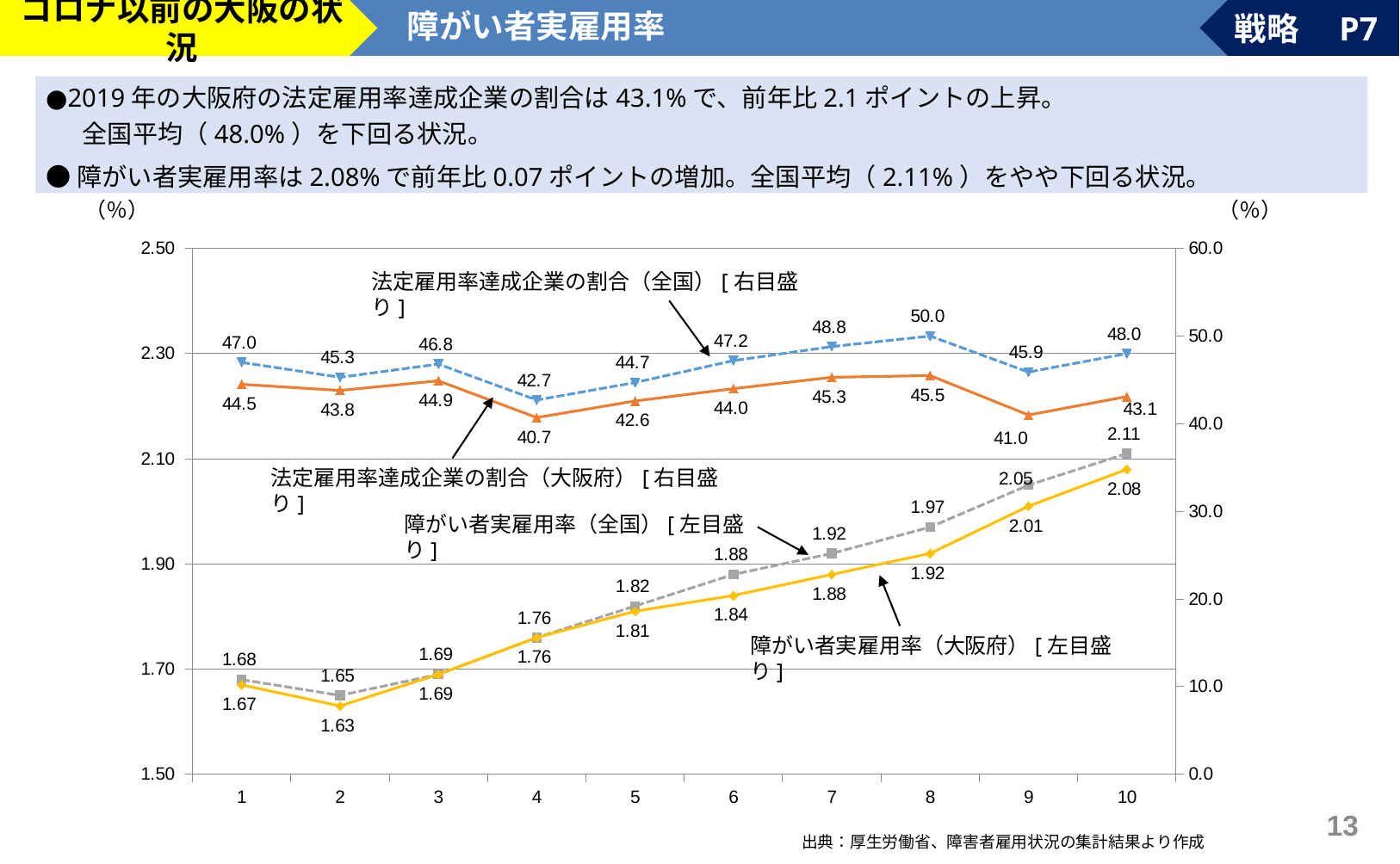
横軸には何個のデータ点（1〜10）がありますか？ 10 障がい者実雇用率（大阪府）は横軸の3から10にかけて上昇していますか、下降していますか？ 上昇 9番目の点における法定雇用率達成企業の割合の全国と大阪府の差はいくつですか？ 4.9 障がい者実雇用率（大阪府）の2番目の値はいくつですか？ 1.63 法定雇用率達成企業の割合（全国）が最も高いのは横軸のどの点ですか？ 8 障がい者実雇用率（全国）の10番目の値はいくつですか？ 2.11 10番目の点における障がい者実雇用率の全国と大阪府の差はいくつですか？ 0.03 法定雇用率達成企業の割合（全国）の8番目の値はいくつですか？ 50.0 このグラフはどの種類のグラフですか？ 折れ線グラフ 7番目の点では、障がい者実雇用率は全国と大阪府のどちらが高いですか？ 全国 法定雇用率達成企業の割合（大阪府）の10番目の値はいくつですか？ 43.1 法定雇用率達成企業の割合（大阪府）が最も低いのは横軸のどの点ですか？ 4